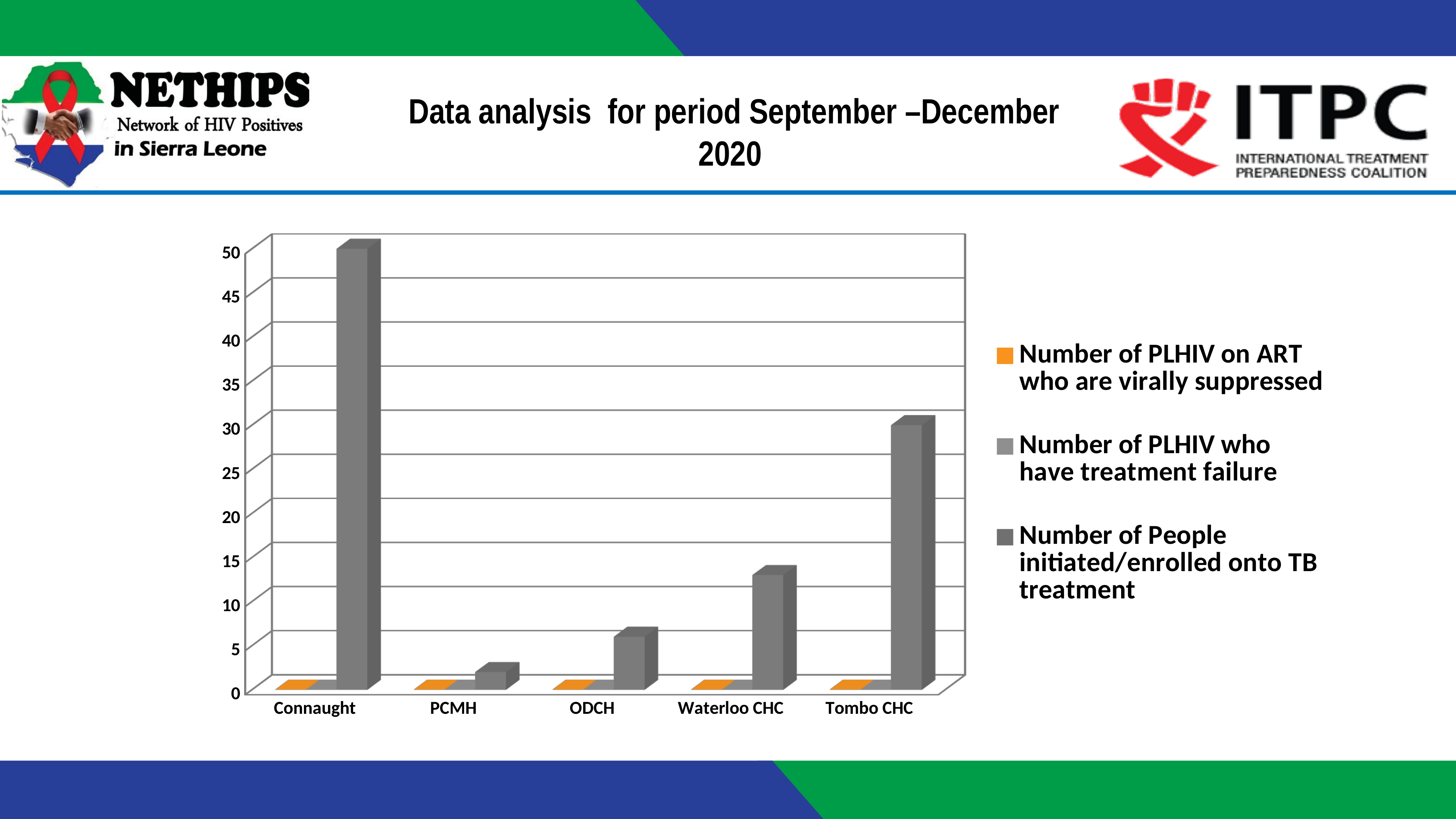
Is the number of people initiated/enrolled onto TB treatment at ODCH greater or less than 10? less Is the number of people initiated/enrolled onto TB treatment at PCMH greater or less than 5? less Which has more people initiated/enrolled onto TB treatment, Waterloo CHC or Tombo CHC? Tombo CHC Is the number of people initiated/enrolled onto TB treatment at Waterloo CHC greater or less than 10? greater What kind of chart is shown on the slide? bar chart How many facilities (categories) are shown on the x axis of the chart? 5 What is the title of the slide containing the chart? Data analysis for period September –December 2020 How many series does the chart's legend list? 3 Which facility has the lowest number of people initiated/enrolled onto TB treatment? PCMH Which colour represents the series 'Number of PLHIV on ART who are virally suppressed' in the legend? orange Which facility has the highest number of people initiated/enrolled onto TB treatment? Connaught